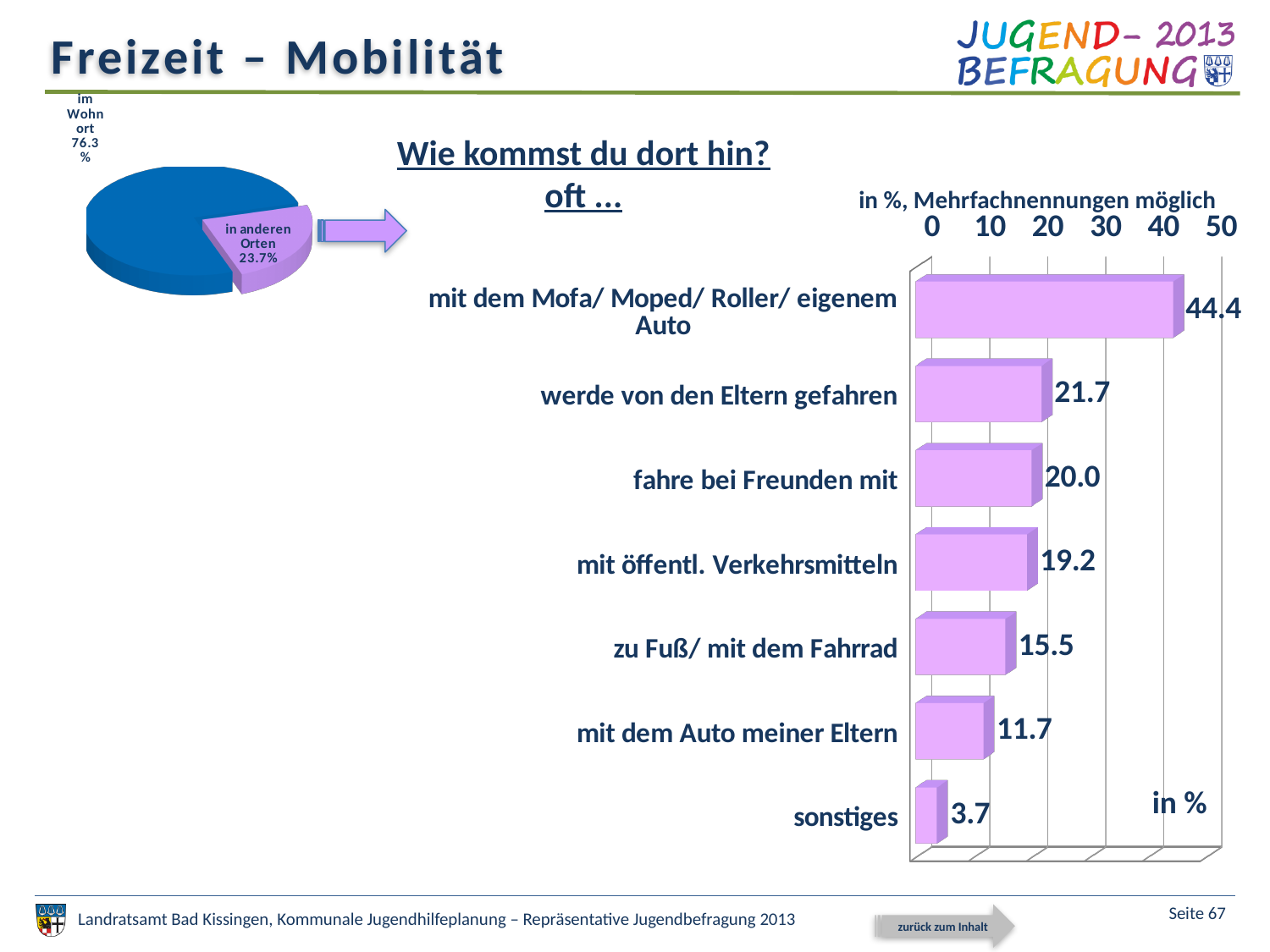
In the bar chart 'Wie kommst du dort hin? oft ...', what is the value for 'werde von den Eltern gefahren'? 21.7 In the bar chart 'Wie kommst du dort hin? oft ...', what is the difference between 'werde von den Eltern gefahren' and 'mit dem Auto meiner Eltern'? 10.0 In the bar chart 'Wie kommst du dort hin? oft ...', what is the value for 'mit dem Mofa/ Moped/ Roller/ eigenem Auto'? 44.4 In the bar chart 'Wie kommst du dort hin? oft ...', how many categories are shown? 7 What kind of chart is shown at the top left of the slide? pie chart In the pie chart at the top left, what is the share for 'in anderen Orten'? 23.7% In the bar chart 'Wie kommst du dort hin? oft ...', which category has the lowest value? sonstiges What kind of chart is the chart on the right side of the slide? bar chart In the bar chart 'Wie kommst du dort hin? oft ...', which category has the highest value? mit dem Mofa/ Moped/ Roller/ eigenem Auto In the bar chart 'Wie kommst du dort hin? oft ...', what is the value for 'zu Fuß/ mit dem Fahrrad'? 15.5 In the bar chart 'Wie kommst du dort hin? oft ...', which is larger: 'fahre bei Freunden mit' or 'mit öffentl. Verkehrsmitteln'? fahre bei Freunden mit In the pie chart at the top left, what is the share for 'im Wohnort'? 76.3%